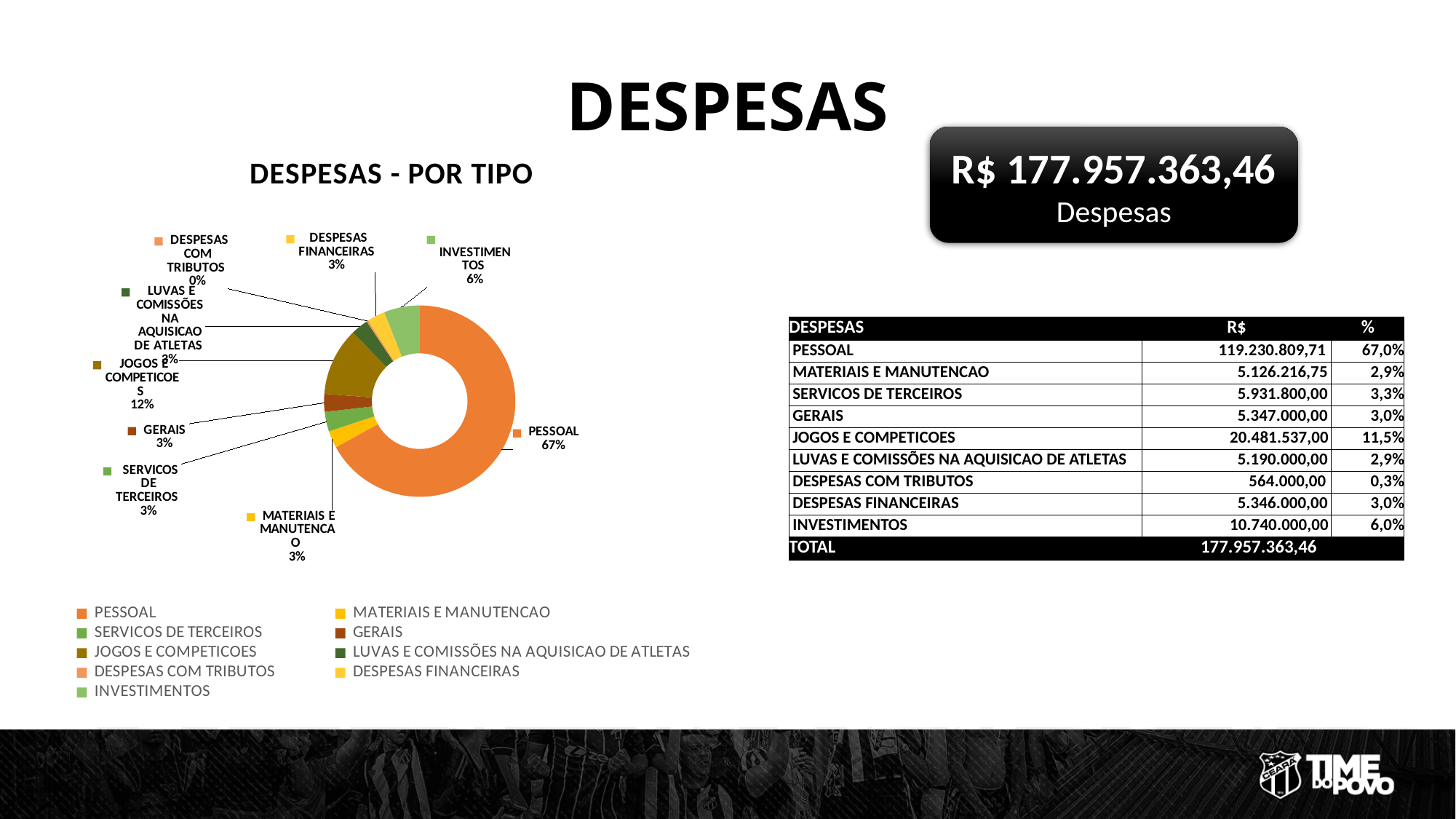
What is the title of the pie chart on the slide? DESPESAS - POR TIPO Which category has the largest slice in the 'DESPESAS - POR TIPO' chart? PESSOAL In the 'DESPESAS - POR TIPO' chart, what share is labelled for INVESTIMENTOS? 6% In the 'DESPESAS - POR TIPO' chart, what share is labelled for JOGOS E COMPETICOES? 12% Which category has the smallest slice in the 'DESPESAS - POR TIPO' chart? DESPESAS COM TRIBUTOS In the 'DESPESAS - POR TIPO' chart, which slice is larger: JOGOS E COMPETICOES or INVESTIMENTOS? JOGOS E COMPETICOES In the 'DESPESAS - POR TIPO' chart, what share is labelled for PESSOAL? 67% How many categories are shown in the 'DESPESAS - POR TIPO' chart? 9 What kind of chart is 'DESPESAS - POR TIPO'? Pie chart (doughnut) In the 'DESPESAS - POR TIPO' chart, what share is labelled for DESPESAS FINANCEIRAS? 3% In the 'DESPESAS - POR TIPO' chart, what is the difference in percentage points between PESSOAL and JOGOS E COMPETICOES? 55 percentage points In the 'DESPESAS - POR TIPO' chart, what share is labelled for DESPESAS COM TRIBUTOS? 0%